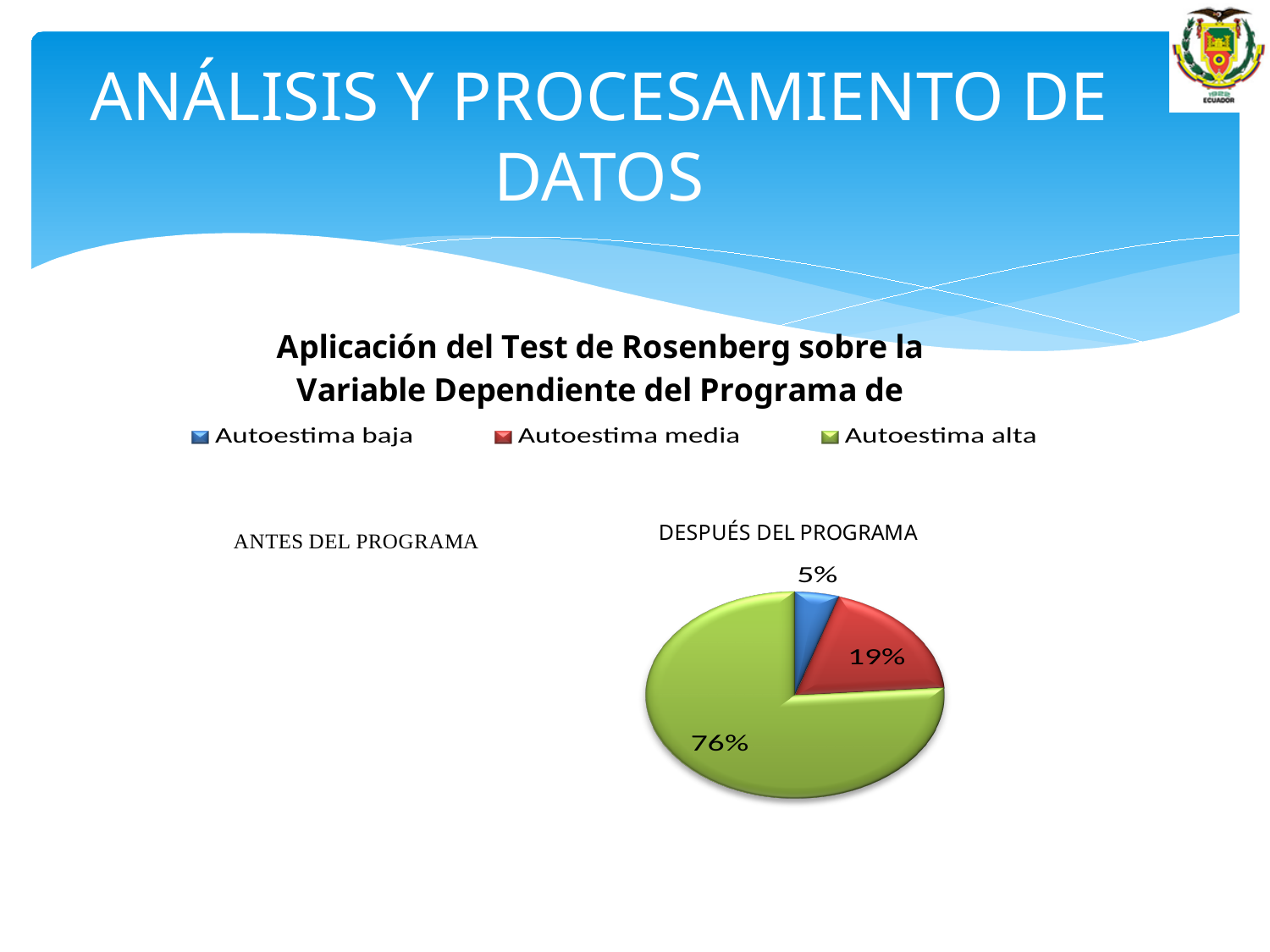
In the DESPUÉS DEL PROGRAMA chart, which is larger: Autoestima media or Autoestima baja? Autoestima media In the DESPUÉS DEL PROGRAMA chart, what is the combined share of Autoestima baja and Autoestima media? 24% In the DESPUÉS DEL PROGRAMA chart, which category has the largest slice? Autoestima alta How many slices does the DESPUÉS DEL PROGRAMA pie chart have? 3 In the DESPUÉS DEL PROGRAMA chart, which category has the smallest slice? Autoestima baja What type of chart is the DESPUÉS DEL PROGRAMA chart? Pie chart In the DESPUÉS DEL PROGRAMA chart, what is the difference in percentage points between Autoestima alta and Autoestima media? 57 In the DESPUÉS DEL PROGRAMA chart, what percentage is shown for Autoestima baja? 5% In the DESPUÉS DEL PROGRAMA chart, what colour represents Autoestima alta? Green In the DESPUÉS DEL PROGRAMA chart, what percentage is shown for Autoestima alta? 76% How many entries does the chart legend list? 3 In the DESPUÉS DEL PROGRAMA chart, what percentage is shown for Autoestima media? 19%